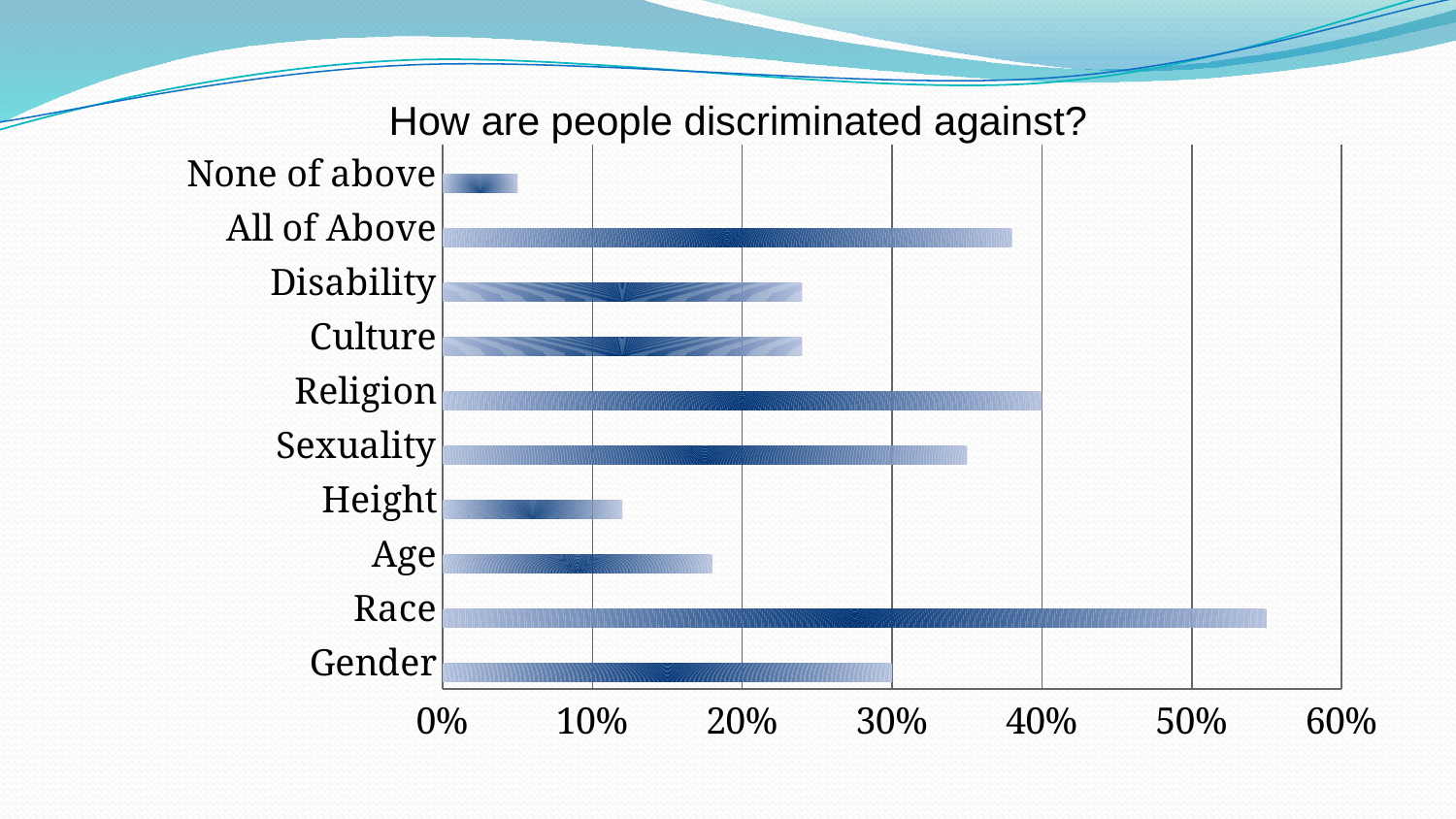
Which has a larger value, Sexuality or Age? Sexuality Is the value for None of above greater or less than 10%? less Is the value for Sexuality greater or less than 30%? greater Which has a larger value, Race or Gender? Race What kind of chart is shown on the slide? bar chart Is the value for Age greater or less than 20%? less Which category has the highest value? Race What is the title of the chart? How are people discriminated against? Which category has the lowest value? None of above How many categories are plotted in the chart? 10